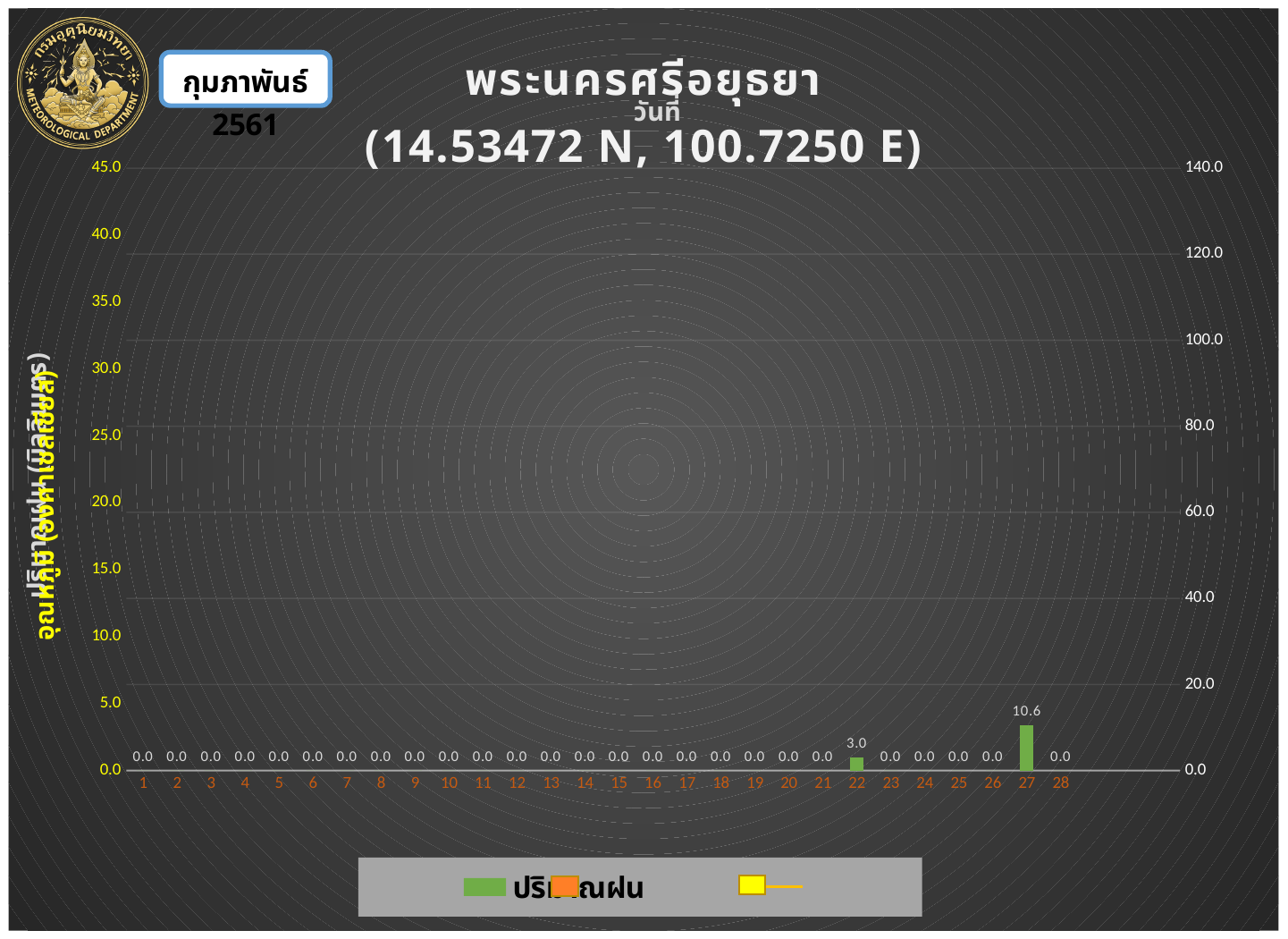
What is the rainfall value shown for day 15? 0.0 What kind of chart is used to show the rainfall values? bar chart Which day has the highest rainfall value? 27 What is the rainfall value shown for day 28? 0.0 How many days are shown on the x axis? 28 What is the difference between the rainfall values on day 27 and day 22? 7.6 How many days have a rainfall value greater than 0.0? 2 What is the highest tick value on the right vertical axis? 140.0 Which has the larger rainfall value, day 22 or day 27? day 27 What is the highest tick value on the left vertical axis? 45.0 What is the rainfall value shown for day 27? 10.6 What is the rainfall value shown for day 22? 3.0